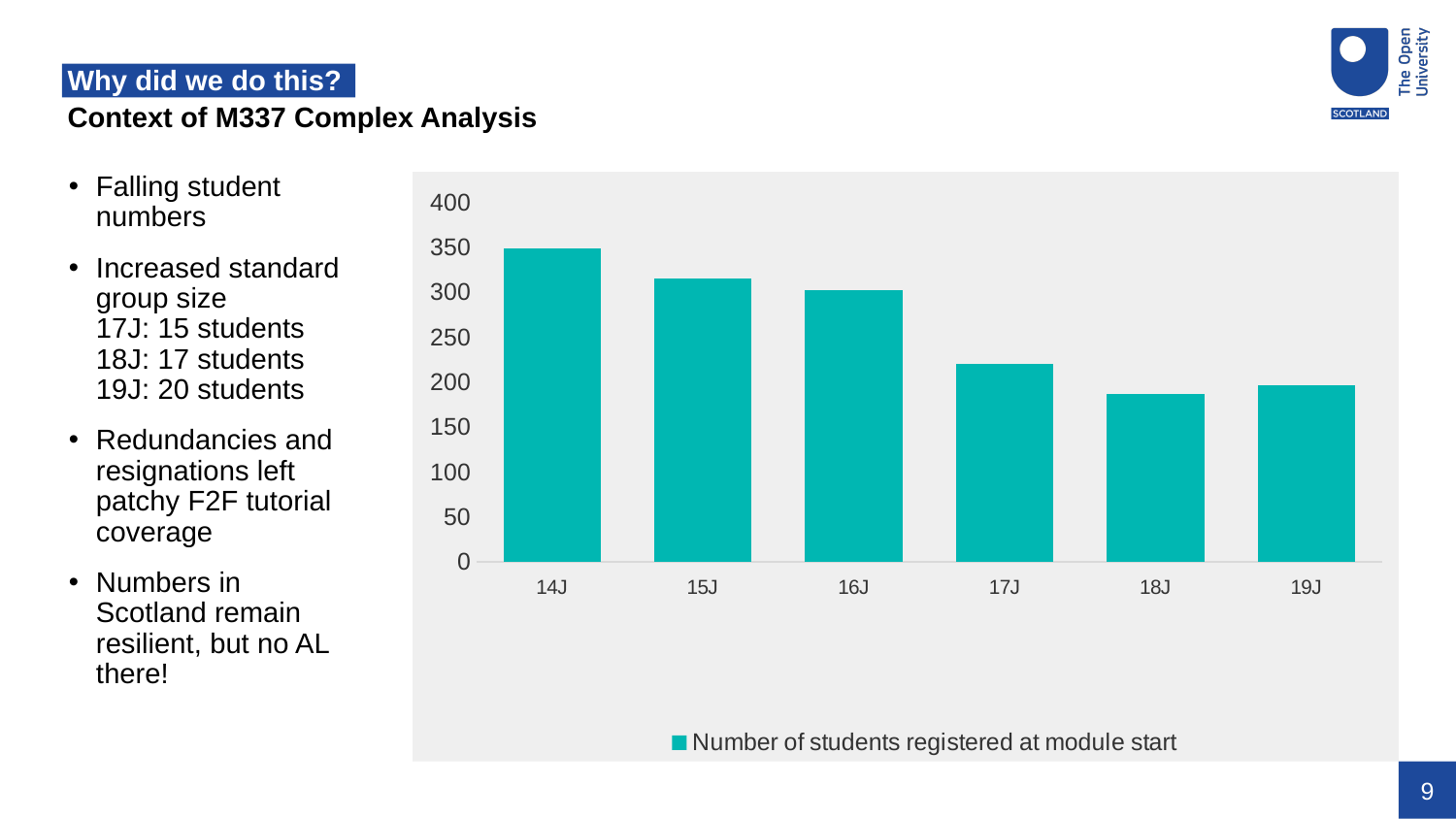
What is the series name shown in the chart legend? Number of students registered at module start How many categories (presentations) are shown on the x axis of the chart? 6 Which presentation has the lowest number of students registered at module start? 18J Do the student numbers generally rise or fall from 14J to 19J? Fall Is the value for 18J greater or less than 200? less What kind of chart is shown on the slide? Bar chart Is the value for 17J greater or less than 200? greater Which has more students registered at module start, 14J or 17J? 14J Is the value for 15J greater or less than 250? greater How many series does the chart legend list? 1 Which presentation has the highest number of students registered at module start? 14J